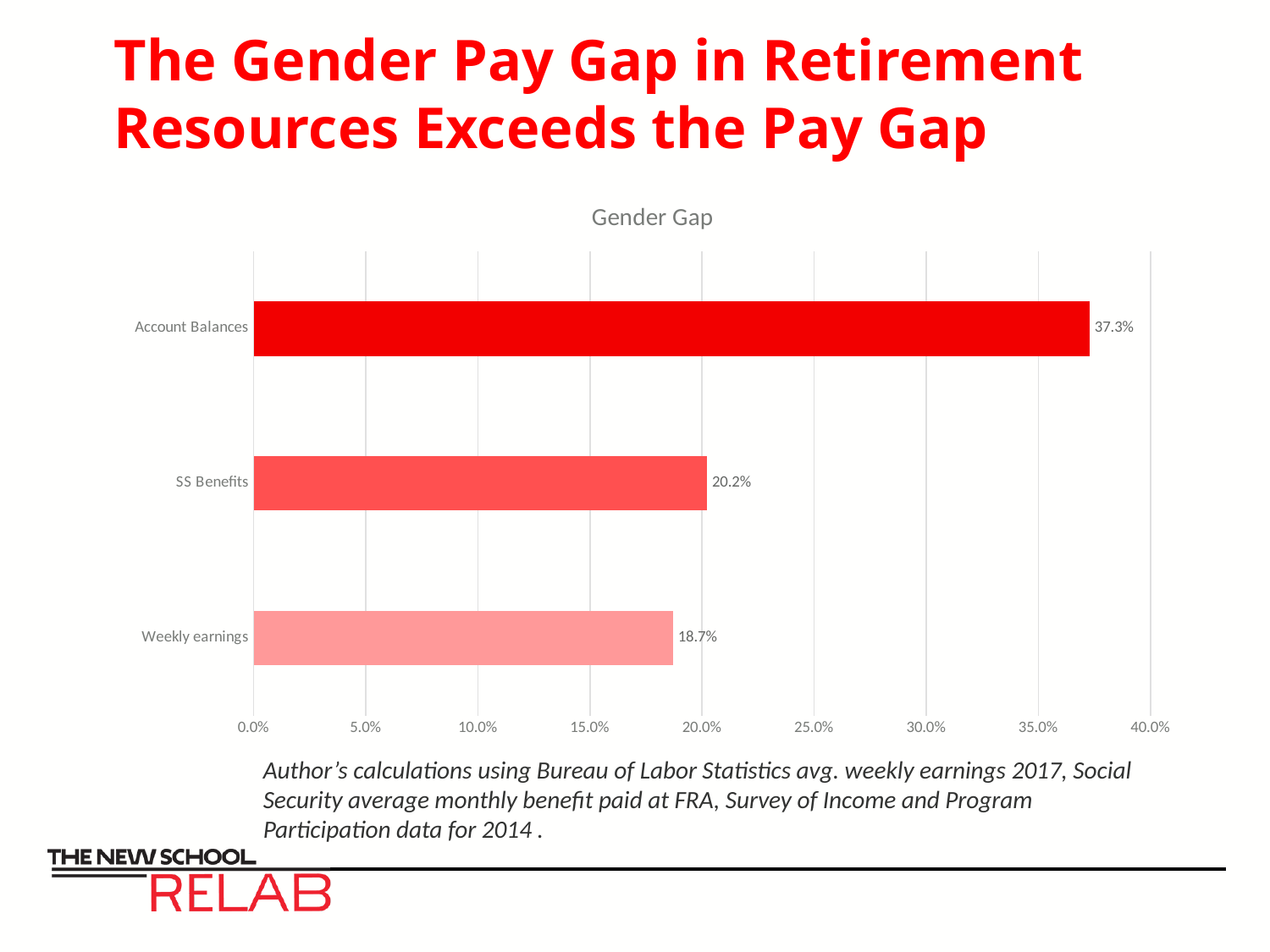
What is the gender gap value for Weekly earnings? 18.7% Which is larger, the gender gap for Account Balances or for Weekly earnings? Account Balances How many categories are shown in the chart? 3 What is the difference between the gender gap for SS Benefits and for Weekly earnings? 1.5% What kind of chart is shown on the slide? bar chart What is the gender gap value for Account Balances? 37.3% What is the title of the chart? Gender Gap What is the difference between the gender gap for Account Balances and for SS Benefits? 17.1% Which category has the lowest gender gap? Weekly earnings Which category has the highest gender gap? Account Balances Is the value for Account Balances greater or less than 35.0%? greater What is the gender gap value for SS Benefits? 20.2%